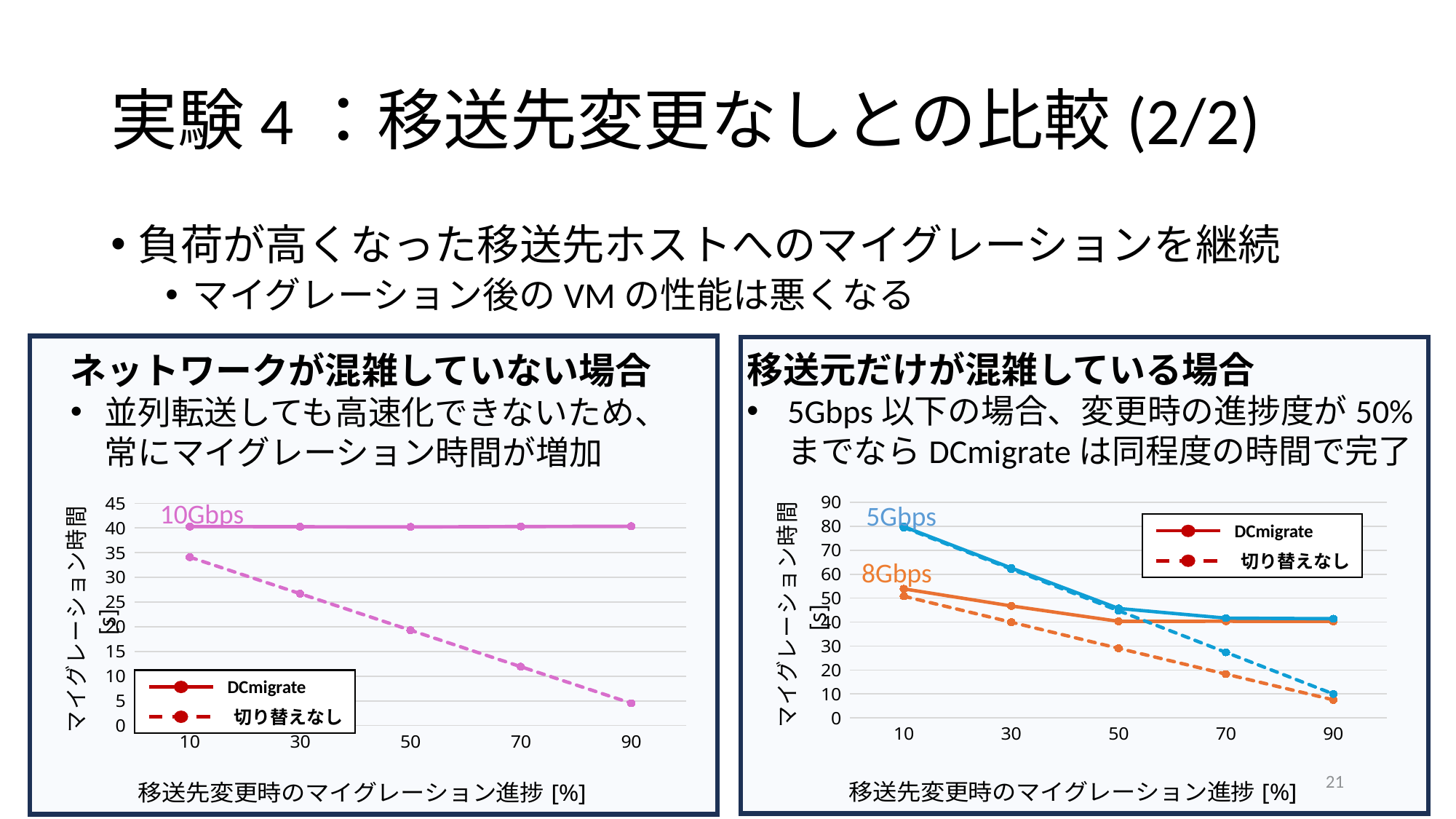
In the left chart (ネットワークが混雑していない場合), does the dashed 切り替えなし line rise or fall as migration progress increases from 10 to 90? fall In the left chart (ネットワークが混雑していない場合), is the value of the dashed 切り替えなし line at 90% greater or less than 10? less In the left chart (ネットワークが混雑していない場合), how many x-axis points (migration progress values) are plotted? 5 In the right chart (移送元だけが混雑している場合), how many series does the legend list? 2 What is the x-axis label of the right chart (移送元だけが混雑している場合)? 移送先変更時のマイグレーション進捗 [%] In the right chart (移送元だけが混雑している場合), does the solid 5Gbps DCmigrate line rise or fall from 10% to 50% progress? fall What kind of chart is shown in the left panel (ネットワークが混雑していない場合)? line chart In the left chart (ネットワークが混雑していない場合), at 90% progress, which is larger: the solid DCmigrate line or the dashed 切り替えなし line? DCmigrate In the right chart (移送元だけが混雑している場合), at 10% progress, which solid DCmigrate line has the larger value: 5Gbps or 8Gbps? 5Gbps In the right chart (移送元だけが混雑している場合), is the value of the solid 5Gbps DCmigrate line at 10% greater or less than 70? greater In the right chart (移送元だけが混雑している場合), is the value of the dashed 8Gbps 切り替えなし line at 90% greater or less than 10? less